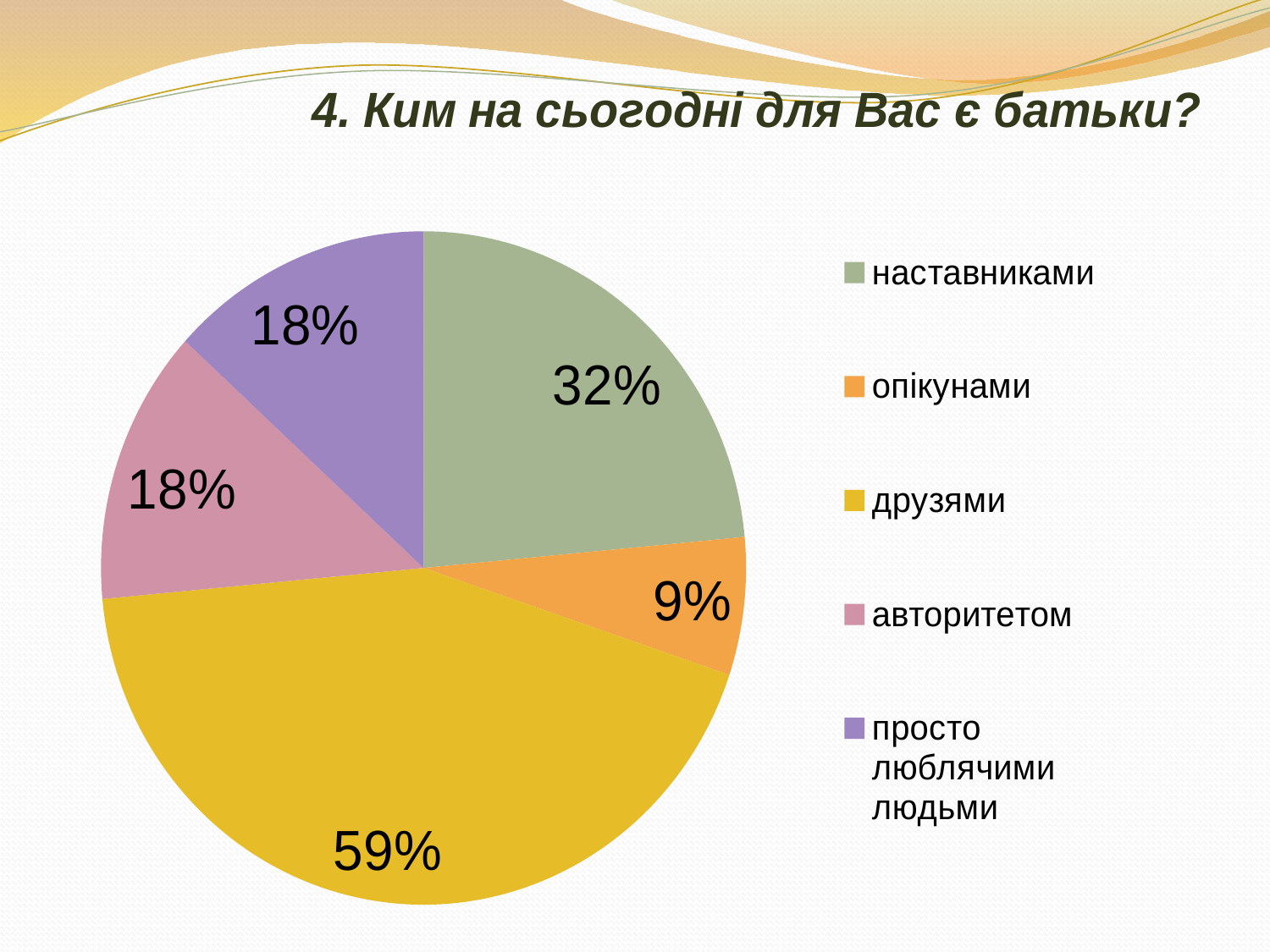
What percentage is shown for the "опікунами" slice? 9% What kind of chart is shown on the slide? pie chart How many categories does the pie chart have? 5 By how many percentage points does the "друзями" slice exceed the "наставниками" slice? 27 Which category has the smallest slice of the pie? опікунами What percentage is shown for the "друзями" slice? 59% What percentage is shown for the "наставниками" slice? 32% What percentage is shown for the "авторитетом" slice? 18% Which slice is larger, "наставниками" or "авторитетом"? наставниками What percentage is shown for the "просто люблячими людьми" slice? 18% Which category has the largest slice of the pie? друзями What is the title of the slide above the chart? 4. Ким на сьогодні для Вас є батьки?